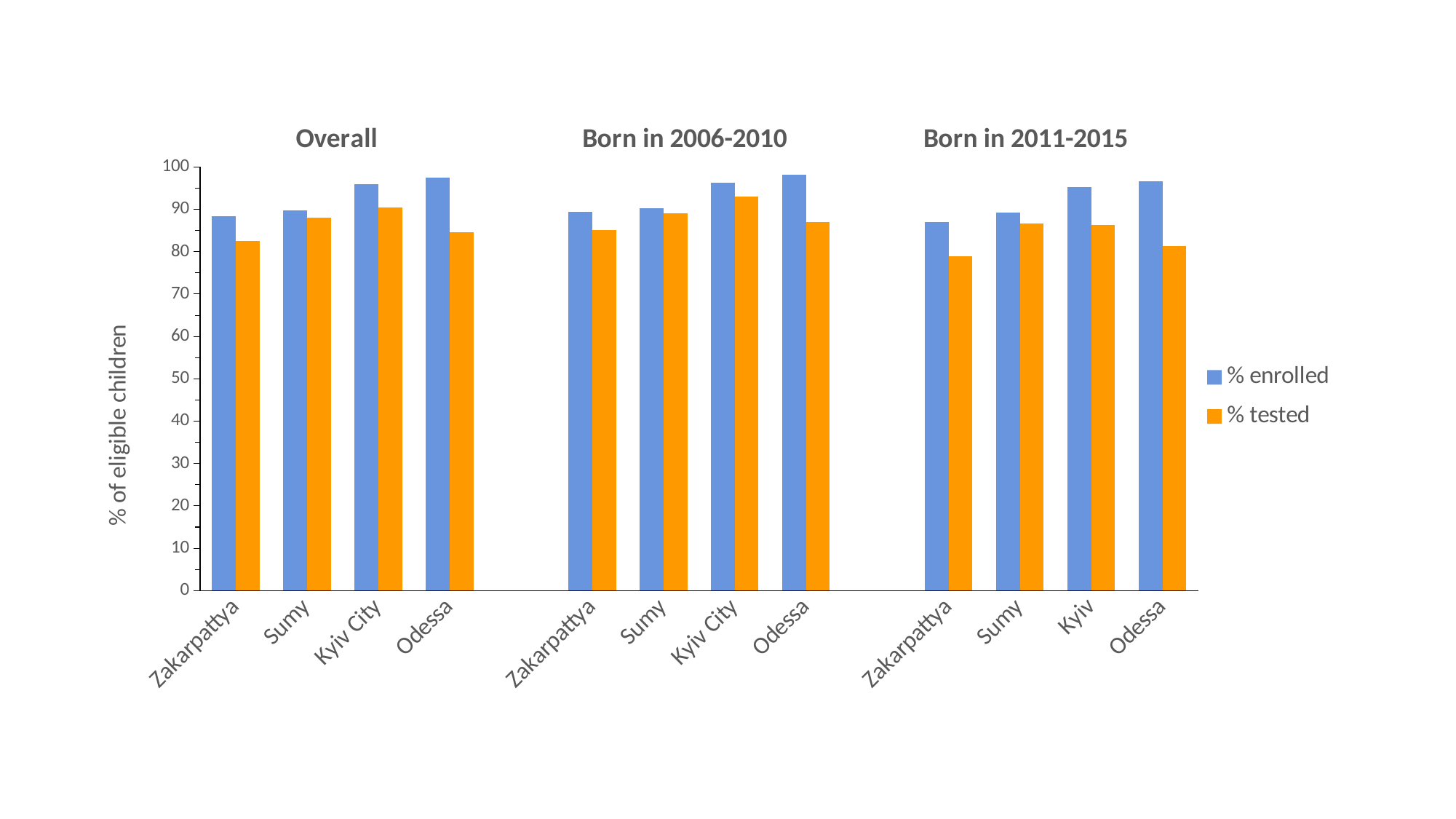
How many series does the legend list? 2 In the Overall group, which is larger: the % tested for Kyiv City or the % tested for Odessa? Kyiv City What kind of chart is shown on the slide? bar chart What are the two series named in the legend? % enrolled and % tested In the Overall group, is the % enrolled value for Odessa greater or less than 90? greater In the Overall group, which region has the highest % enrolled? Odessa In the Born in 2011-2015 group, is the % tested value for Kyiv greater or less than 90? less In the Born in 2006-2010 group, which is larger for Odessa: % enrolled or % tested? % enrolled What is the title of the vertical axis? % of eligible children In the Born in 2011-2015 group, which region has the lowest % tested? Zakarpattya In the Overall group, is the % tested value for Zakarpattya greater or less than 90? less How many regions are shown in the Overall group? 4